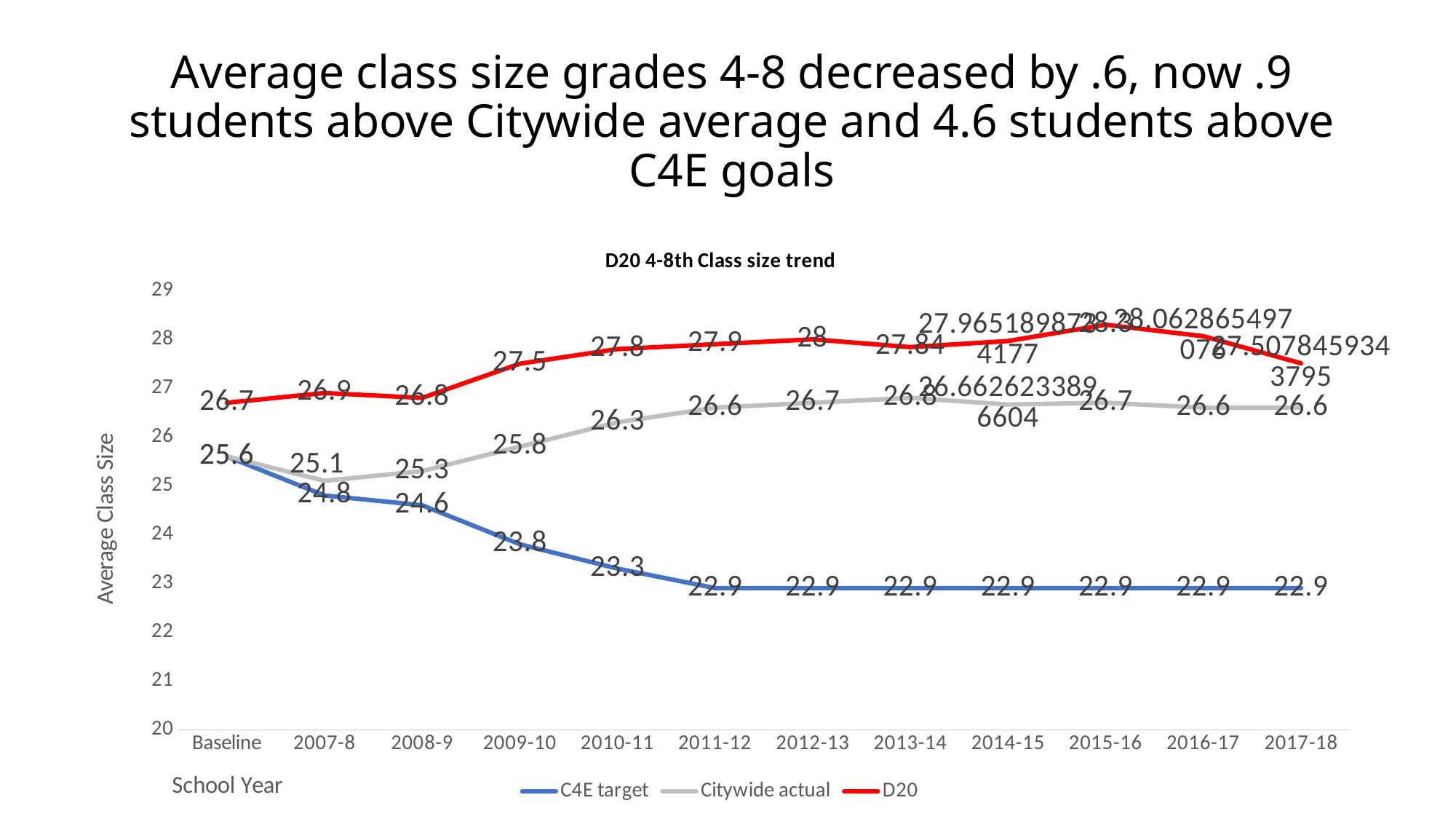
How many school-year categories are shown on the x axis? 12 What is the Citywide actual value for 2008-9? 25.3 Is the Citywide actual value for 2014-15 greater or less than 26? greater What is the Citywide actual value for 2012-13? 26.7 What is the difference between the D20 value and the C4E target value in 2011-12? 5 How many series does the legend list? 3 What kind of chart is shown on the slide? line chart What is the D20 value for 2010-11? 27.8 What is the C4E target value for 2009-10? 23.8 In 2009-10, which is larger: the D20 value or the Citywide actual value? D20 What colour is the D20 line in the legend? red Does the C4E target line rise or fall from Baseline to 2011-12? fall